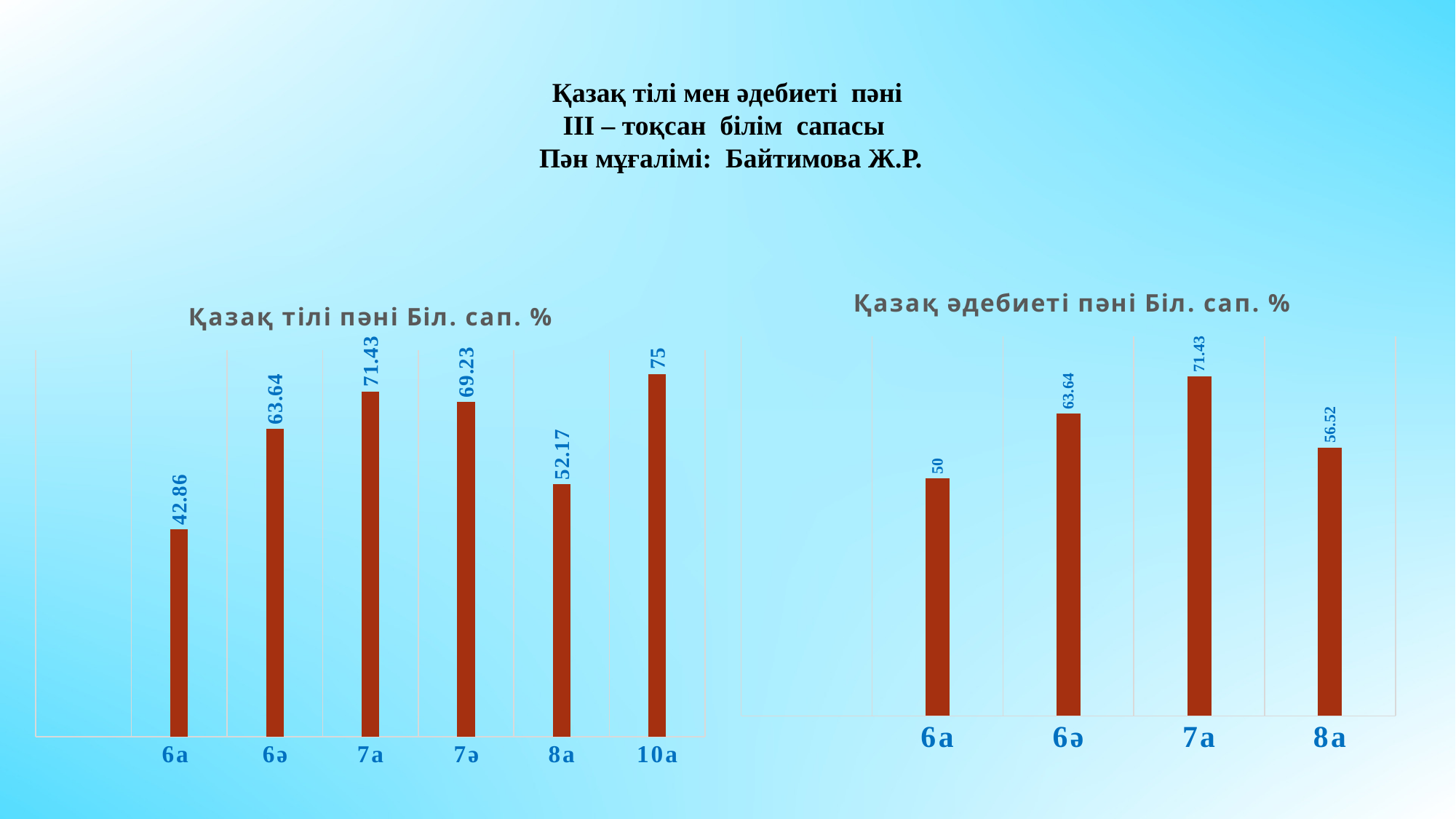
In the left chart (Қазақ тілі пәні Біл. сап. %), which category has the lowest value? 6а What kind of chart is the right chart (Қазақ әдебиеті пәні Біл. сап. %)? Bar chart In the right chart (Қазақ әдебиеті пәні Біл. сап. %), what is the difference between the values for 7а and 6а? 21.43 In the left chart (Қазақ тілі пәні Біл. сап. %), what is the value for 6а? 42.86 In the left chart (Қазақ тілі пәні Біл. сап. %), which category has the highest value? 10а In the right chart (Қазақ әдебиеті пәні Біл. сап. %), which is larger, the value for 6ә or the value for 8а? 6ә In the right chart (Қазақ әдебиеті пәні Біл. сап. %), which category has the lowest value? 6а In the left chart (Қазақ тілі пәні Біл. сап. %), what is the difference between the values for 10а and 6а? 32.14 In the left chart (Қазақ тілі пәні Біл. сап. %), how many categories are shown? 6 In the left chart (Қазақ тілі пәні Біл. сап. %), what is the value for 7ә? 69.23 In the right chart (Қазақ әдебиеті пәні Біл. сап. %), what is the value for 8а? 56.52 In the right chart (Қазақ әдебиеті пәні Біл. сап. %), which category has the highest value? 7а